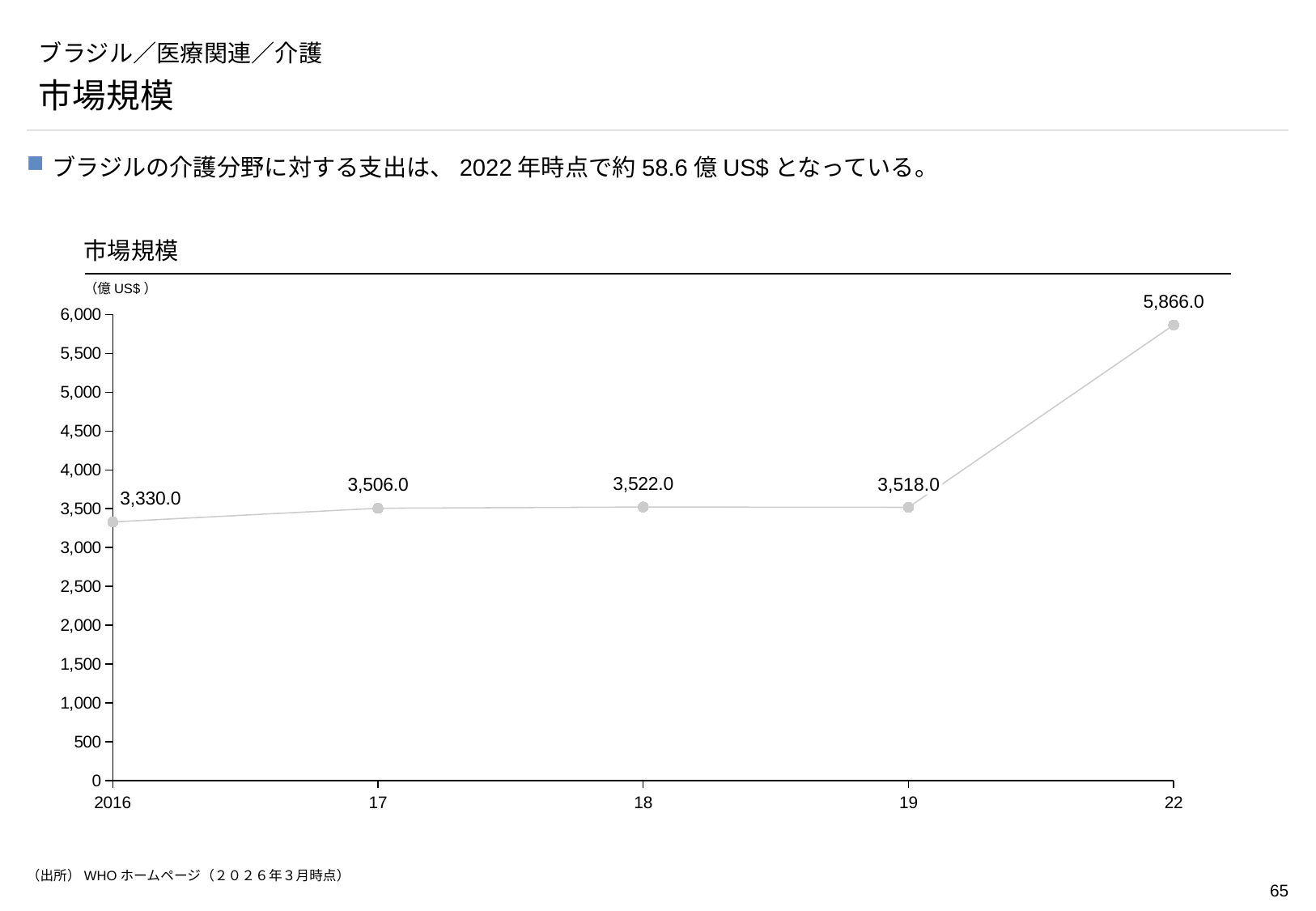
What kind of chart is shown? line chart What is the value for 18? 3,522.0 What is the difference between the values for 22 and 19? 2,348.0 Is the value for 22 greater or less than 5,500? greater What is the value for 2016? 3,330.0 Which year has the highest value? 22 Which is larger, the value for 2016 or the value for 17? 17 What is the value for 22? 5,866.0 How many data points are plotted on the chart? 5 What unit is shown on the chart's y axis? 億 US$ Which year has the lowest value? 2016 What is the difference between the values for 17 and 2016? 176.0